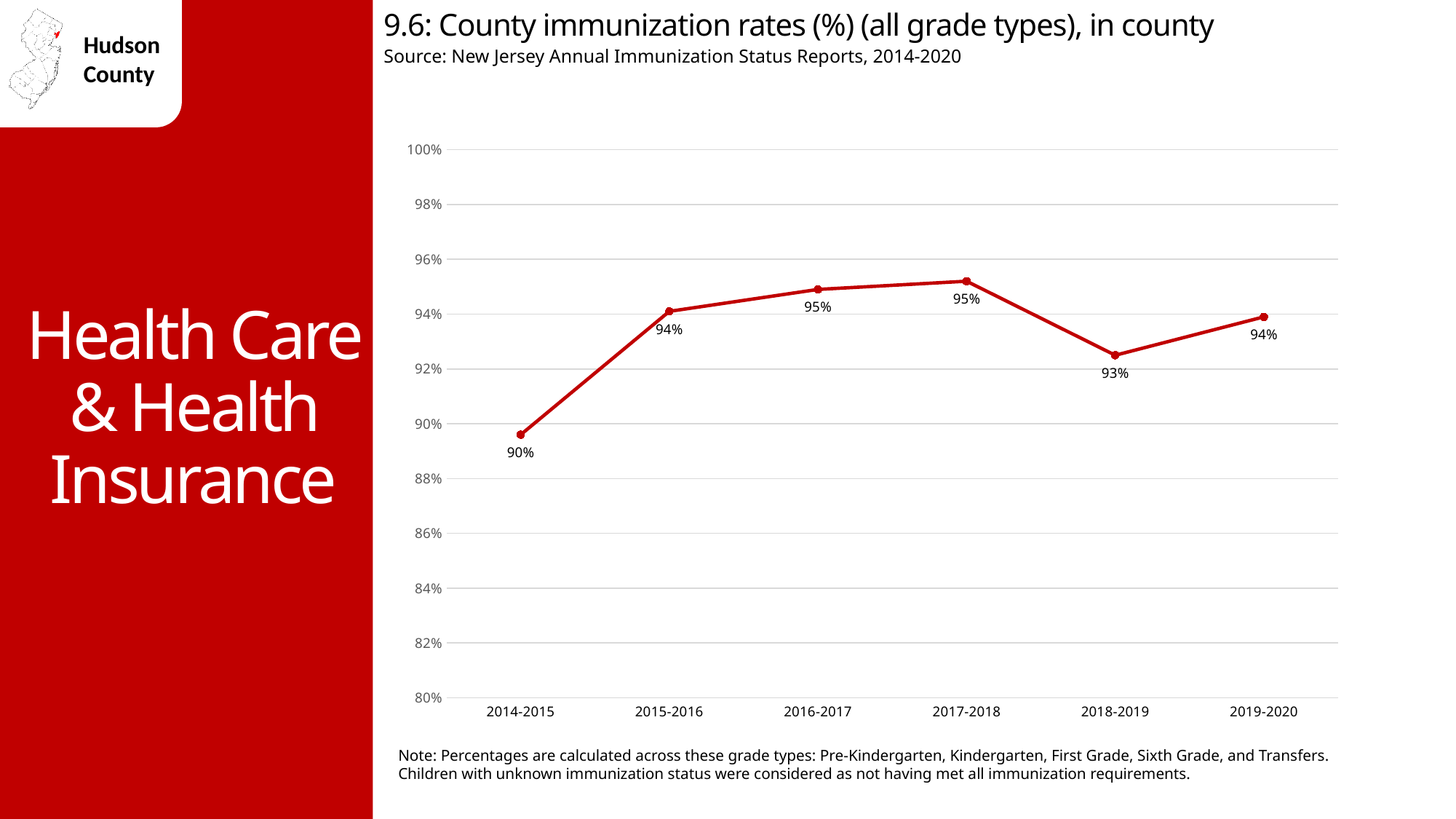
How many school years are plotted on the chart? 6 What is the county immunization rate for 2019-2020? 94% Which school year has the lowest immunization rate? 2014-2015 Does the immunization rate rise or fall from 2014-2015 to 2017-2018? Rise Is the value for 2017-2018 greater or less than 94%? greater What kind of chart is shown on the slide? Line chart What is the county immunization rate for 2016-2017? 95% What is the county immunization rate for 2018-2019? 93% Is the value for 2014-2015 greater or less than 92%? less What is the difference between the immunization rates for 2015-2016 and 2014-2015? 4 percentage points Which has a higher immunization rate, 2014-2015 or 2018-2019? 2018-2019 What is the county immunization rate for 2014-2015? 90%